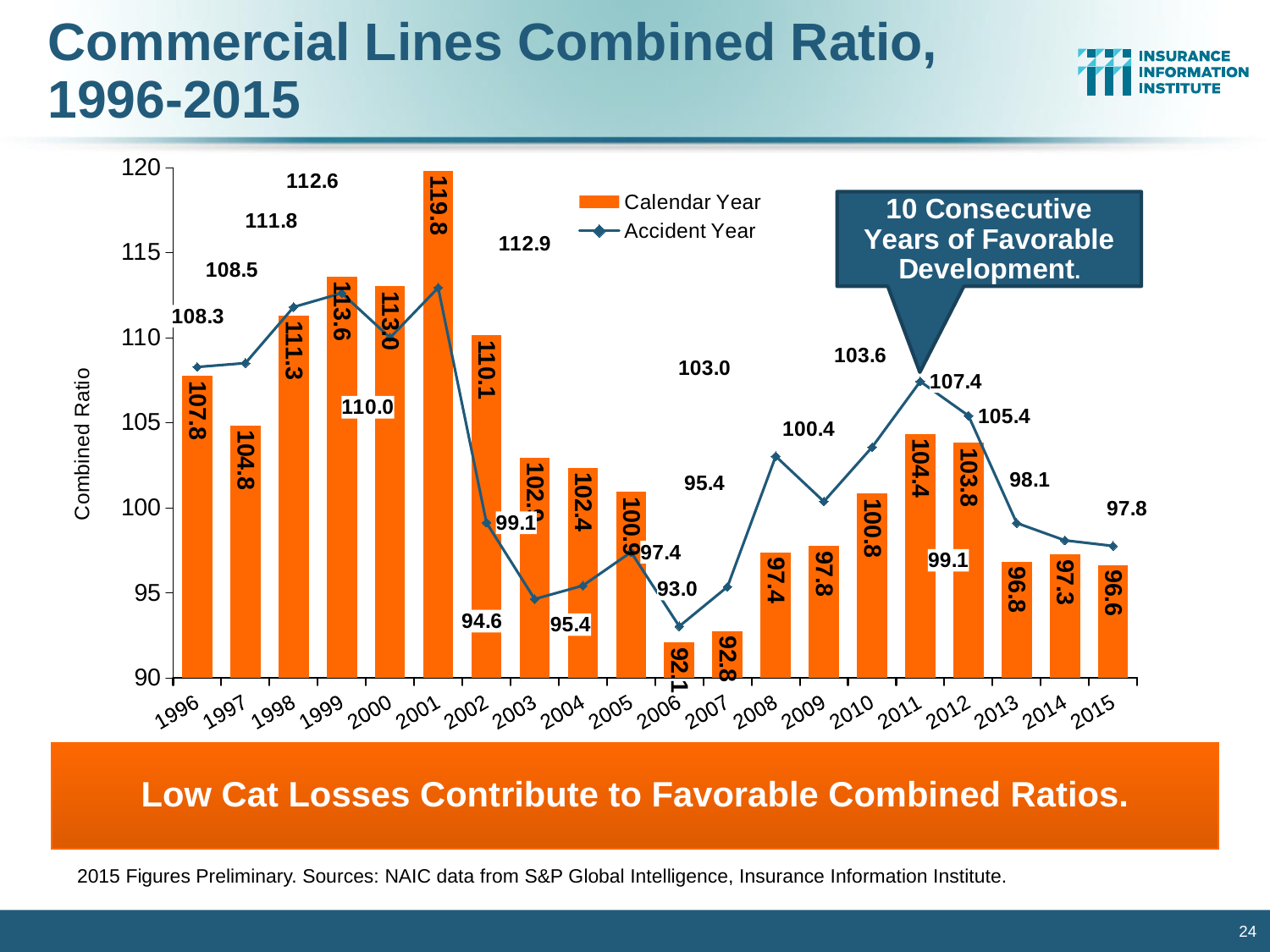
Which year has the highest Calendar Year combined ratio? 2001 What is the difference between the Calendar Year combined ratio in 2001 and in 2006? 27.7 What is the Calendar Year combined ratio for 2001? 119.8 How many years are shown on the x axis? 20 Which is larger in 2012, the Calendar Year combined ratio or the Accident Year combined ratio? Accident Year What is the Calendar Year combined ratio for 2015? 96.6 Did the Calendar Year combined ratio rise or fall from 2001 to 2006? fall How many series does the legend list? 2 What kinds of chart are combined on this slide? A bar chart and a line chart What is the Accident Year combined ratio for 2011? 107.4 Is the Calendar Year combined ratio for 2010 greater or less than 100? greater Which year has the lowest Calendar Year combined ratio? 2006